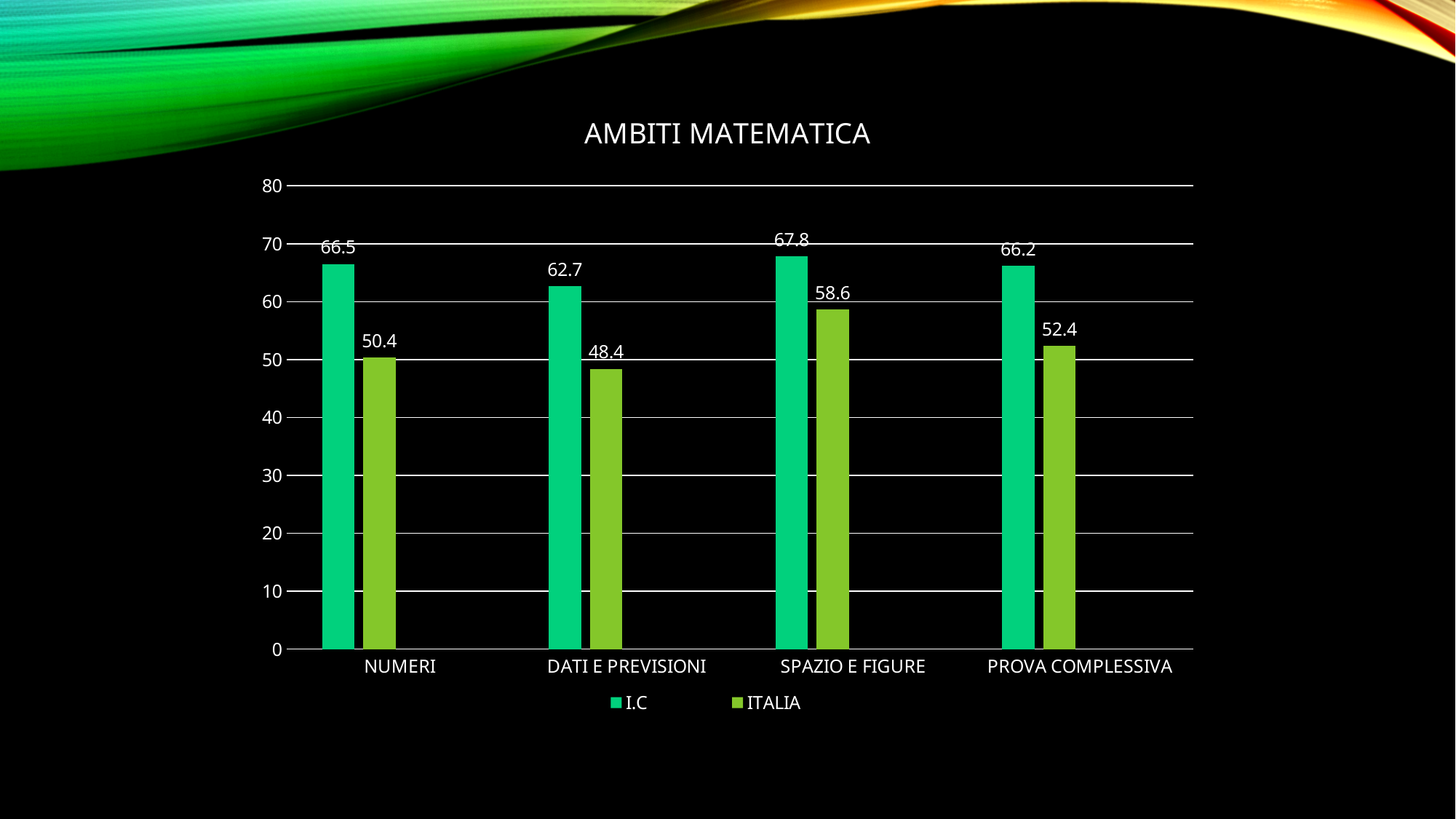
What is the difference between the I.C and ITALIA values for SPAZIO E FIGURE? 9.2 What is the ITALIA value for DATI E PREVISIONI? 48.4 Which category has the highest I.C value? SPAZIO E FIGURE What kind of chart is shown on the slide? bar chart What is the ITALIA value for PROVA COMPLESSIVA? 52.4 How many categories are shown on the x axis? 4 What is the title of the chart? AMBITI MATEMATICA Which is larger for NUMERI, the I.C value or the ITALIA value? I.C How many series does the legend list? 2 What is the I.C value for NUMERI? 66.5 Is the ITALIA value for SPAZIO E FIGURE greater or less than 50? greater Which category has the lowest ITALIA value? DATI E PREVISIONI